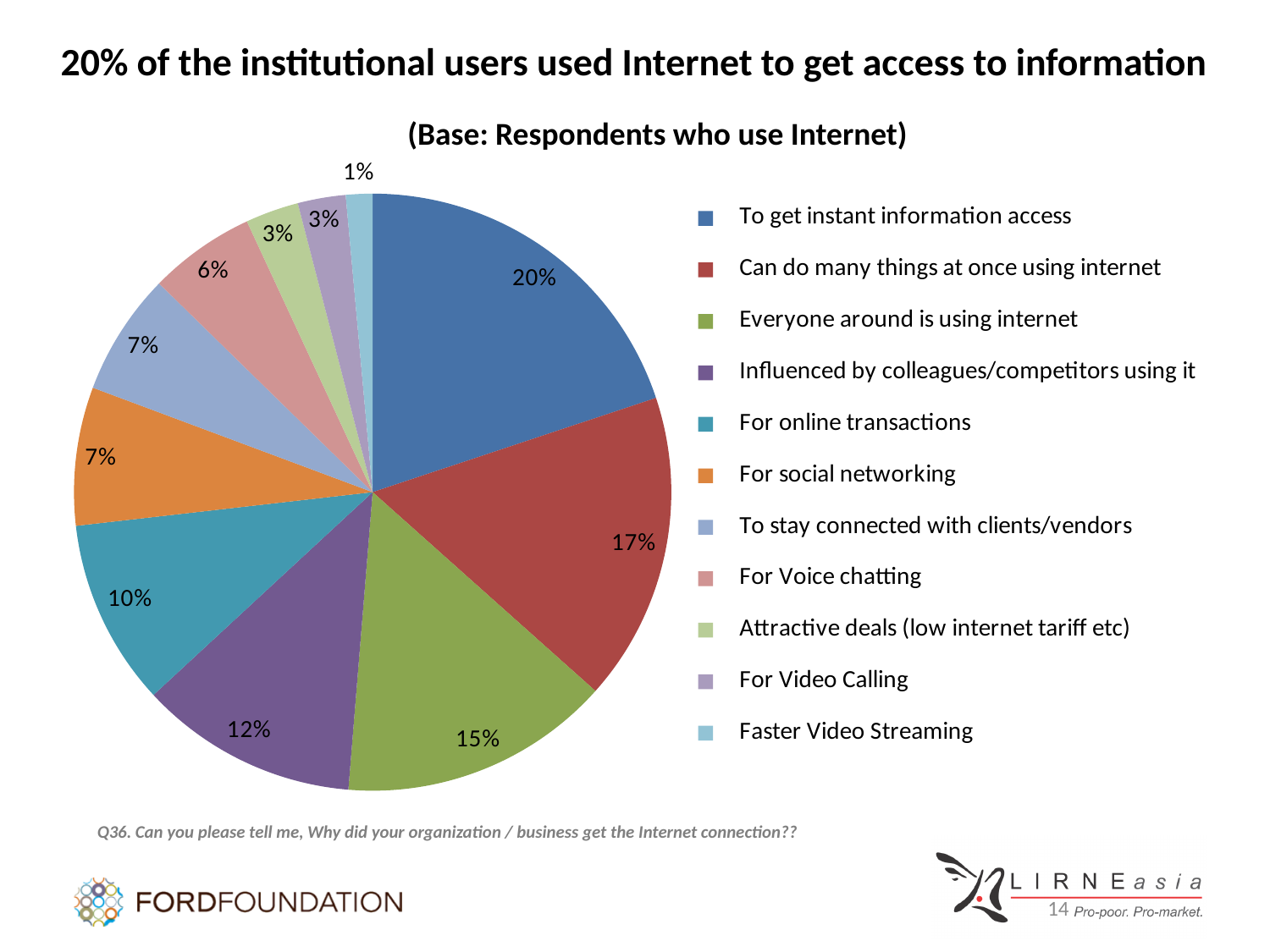
What percentage is shown for 'For Voice chatting'? 6% What share of the pie is for 'To get instant information access'? 20% What percentage is shown for 'For online transactions'? 10% What percentage is shown for 'Influenced by colleagues/competitors using it'? 12% Which is larger: the slice for 'For online transactions' or the slice for 'For social networking'? For online transactions What is the base stated in the chart subtitle? Respondents who use Internet What type of chart is shown on the slide? Pie chart What is the combined share of 'For Video Calling' and 'Faster Video Streaming'? 4% Which reason has the smallest slice of the pie? Faster Video Streaming How many slices does the pie chart have? 11 What is the difference in percentage points between 'Can do many things at once using internet' and 'Everyone around is using internet'? 2 Which reason has the largest slice of the pie? To get instant information access